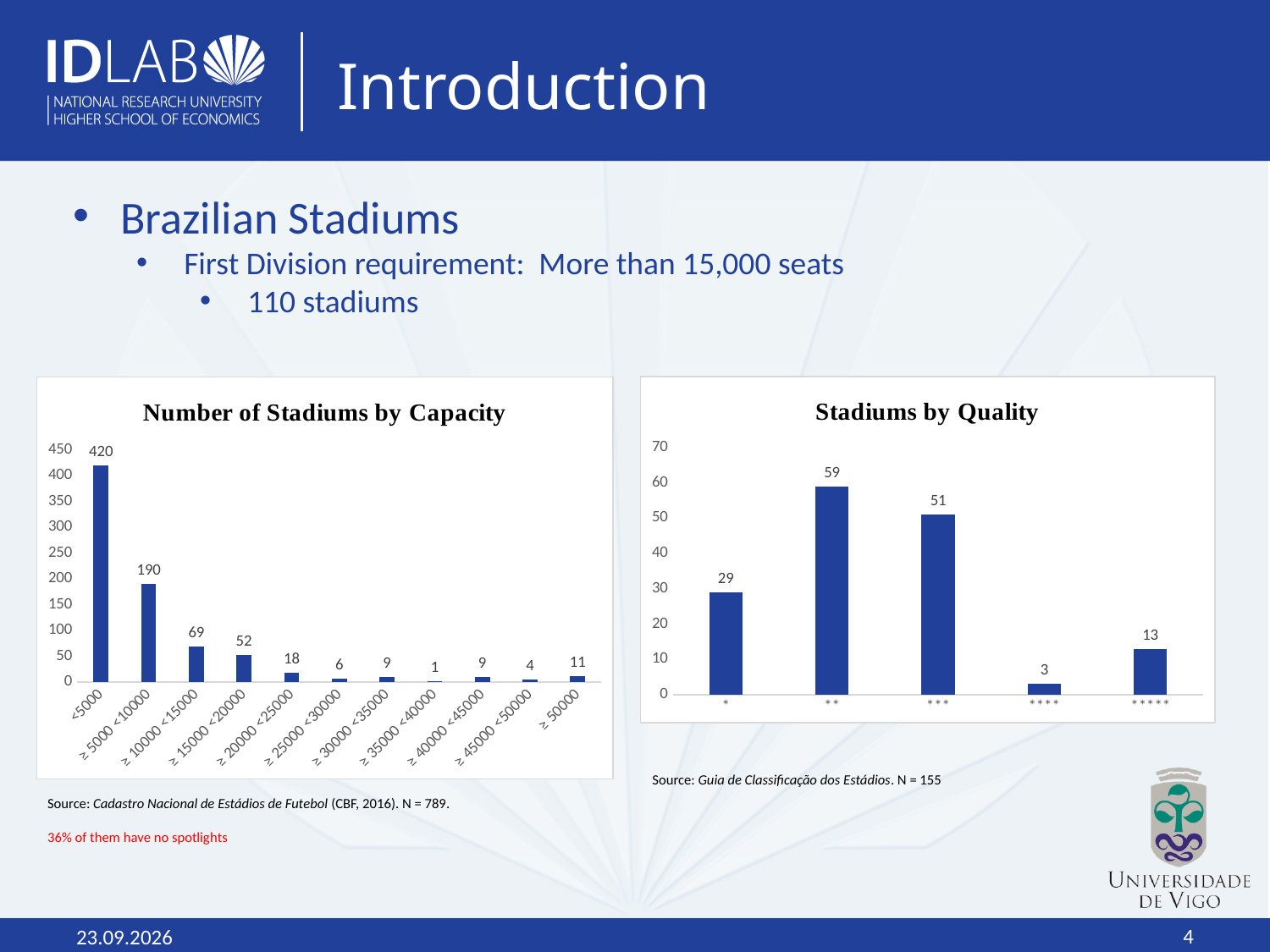
In the 'Stadiums by Quality' chart, which quality rating has the lowest number of stadiums? **** In the 'Number of Stadiums by Capacity' chart, which is larger: the value for ≥ 50000 or the value for ≥ 45000 <50000? ≥ 50000 In the 'Stadiums by Quality' chart, which quality rating has the highest number of stadiums? ** In the 'Stadiums by Quality' chart, what is the difference between the three-star (***) and five-star (*****) values? 38 In the 'Number of Stadiums by Capacity' chart, which capacity category has the lowest number of stadiums? ≥ 35000 <40000 In the 'Number of Stadiums by Capacity' chart, what is the value for the ≥ 15000 <20000 category? 52 In the 'Number of Stadiums by Capacity' chart, how many stadiums have a capacity below 5000? 420 In the 'Number of Stadiums by Capacity' chart, what is the difference between the <5000 and ≥ 5000 <10000 categories? 230 What type of chart is 'Stadiums by Quality'? Bar chart In the 'Stadiums by Quality' chart, how many stadiums are rated two stars (**)? 59 In the 'Number of Stadiums by Capacity' chart, how many capacity categories are shown? 11 In the 'Stadiums by Quality' chart, how many quality categories are shown? 5